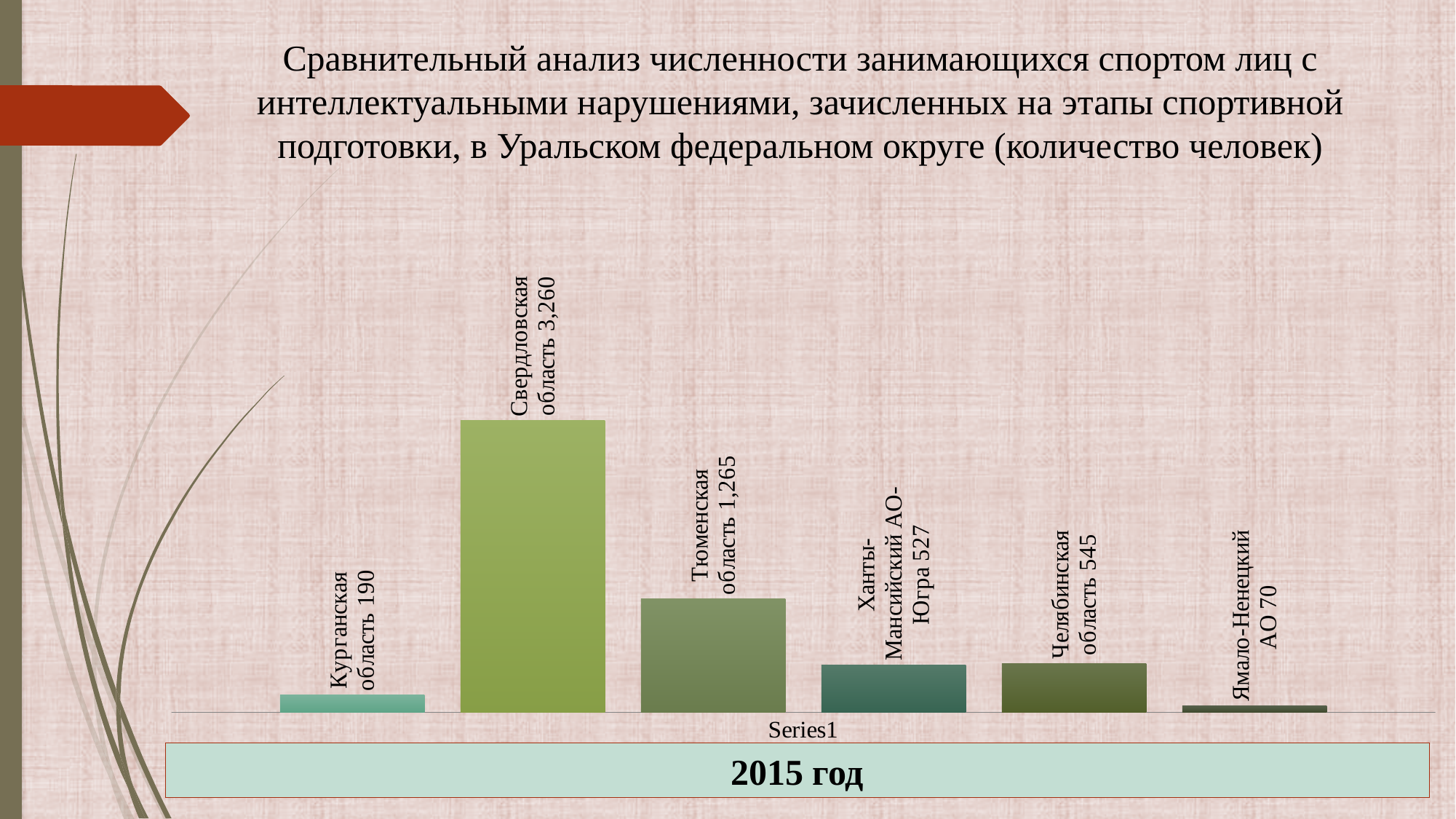
What is the difference between the values for Свердловская область and Тюменская область? 1,995 What is the difference between the values for Курганская область and Ямало-Ненецкий АО? 120 Which is larger, the value for Челябинская область or the value for Ханты-Мансийский АО-Югра? Челябинская область What is the value for Тюменская область? 1,265 Which region has the lowest value? Ямало-Ненецкий АО Which region has the highest value? Свердловская область How many regions are shown in the chart? 6 What is the value for Свердловская область? 3,260 What is the value for Ямало-Ненецкий АО? 70 What year is shown in the box below the chart? 2015 год What kind of chart is shown on the slide? bar chart What is the value for Ханты-Мансийский АО-Югра? 527